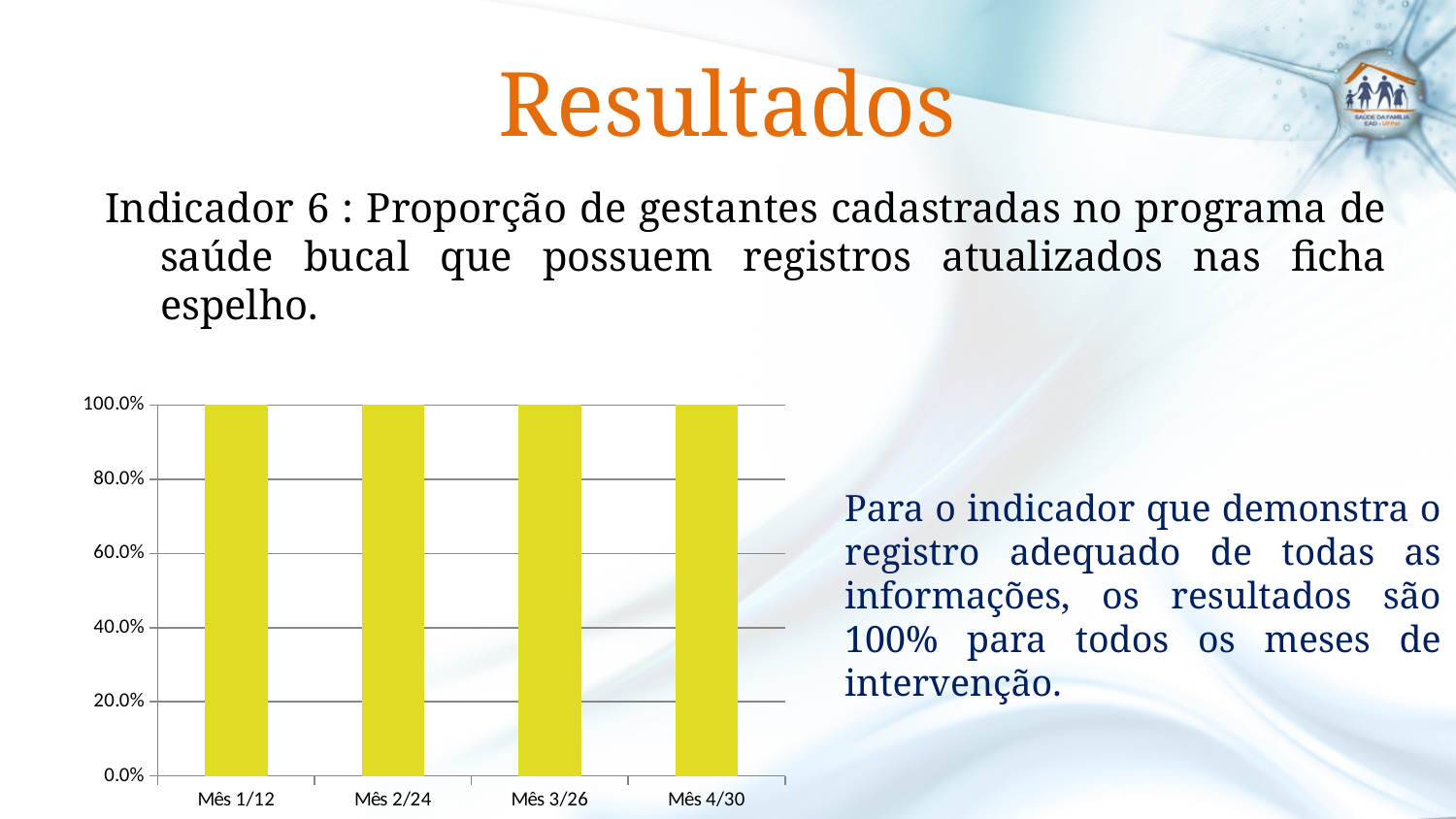
How many bars (categories) does the chart show? 4 What kind of chart is shown on the slide? bar chart What is the difference between the values for Mês 1/12 and Mês 4/30? 0.0% What is the label of the first category on the x axis? Mês 1/12 Is the value for Mês 2/24 greater or less than 80.0%? greater What is the value for Mês 1/12? 100.0% What is the value for Mês 4/30? 100.0% What is the highest value shown on the y axis? 100.0% Do the values rise, fall, or stay the same from Mês 1/12 to Mês 4/30? stay the same What is the value for Mês 3/26? 100.0%